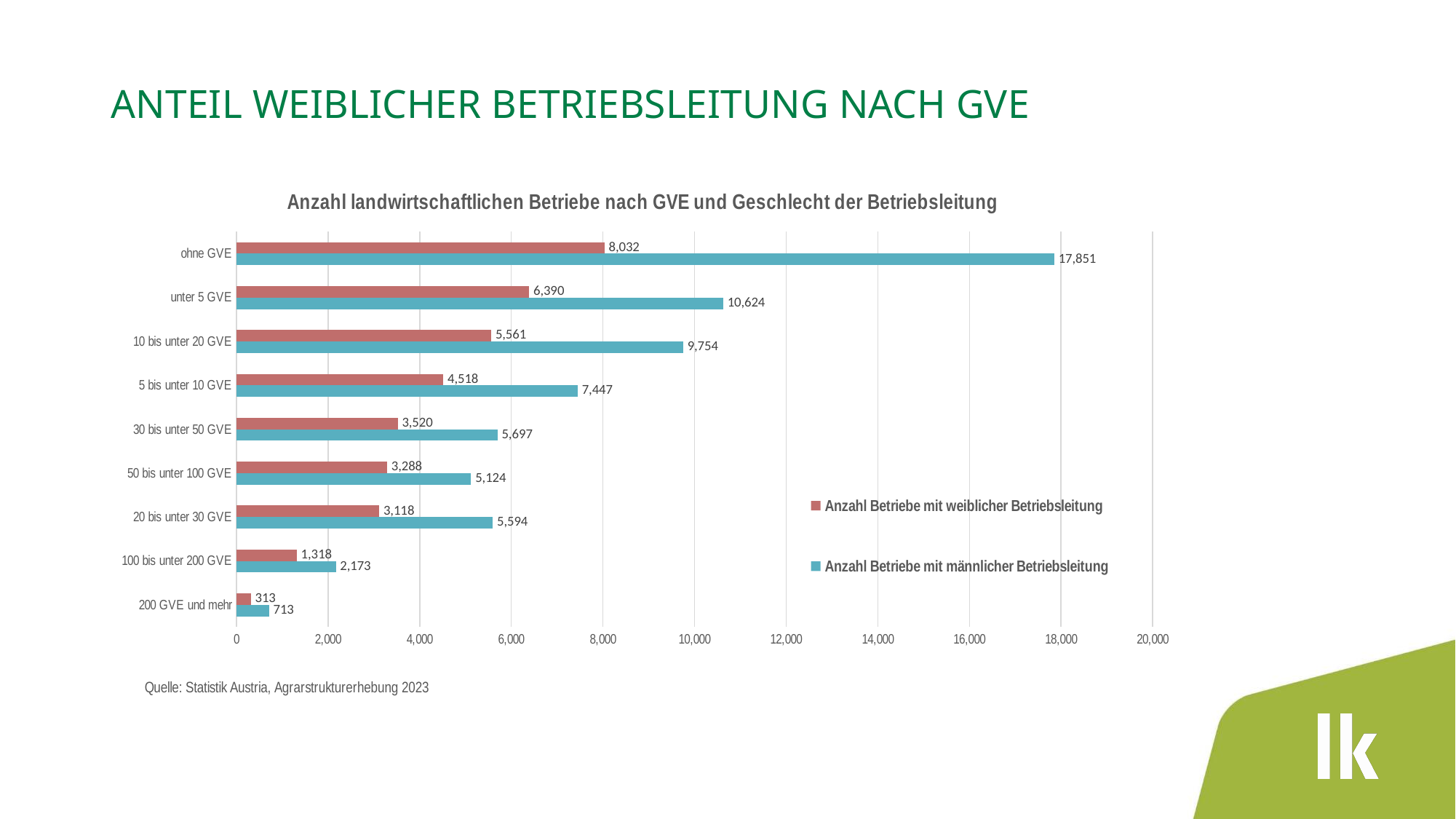
What is the total of female and male management for '100 bis unter 200 GVE'? 3,491 What is the difference between male and female management for 'unter 5 GVE'? 4,234 What is the number of farms with male management (männliche Betriebsleitung) for '10 bis unter 20 GVE'? 9,754 Which category has the highest number of farms with male management? ohne GVE Which is larger for '20 bis unter 30 GVE': the number of farms with female management or with male management? male management (5,594) What is the number of farms with female management (weibliche Betriebsleitung) for 'ohne GVE'? 8,032 What is the title of the chart? Anzahl landwirtschaftlichen Betriebe nach GVE und Geschlecht der Betriebsleitung What kind of chart is shown on the slide? bar chart How many GVE categories are shown on the chart? 9 What is the value for '200 GVE und mehr' in the 'Anzahl Betriebe mit weiblicher Betriebsleitung' series? 313 Which category has the lowest number of farms with female management? 200 GVE und mehr How many series does the legend list? 2